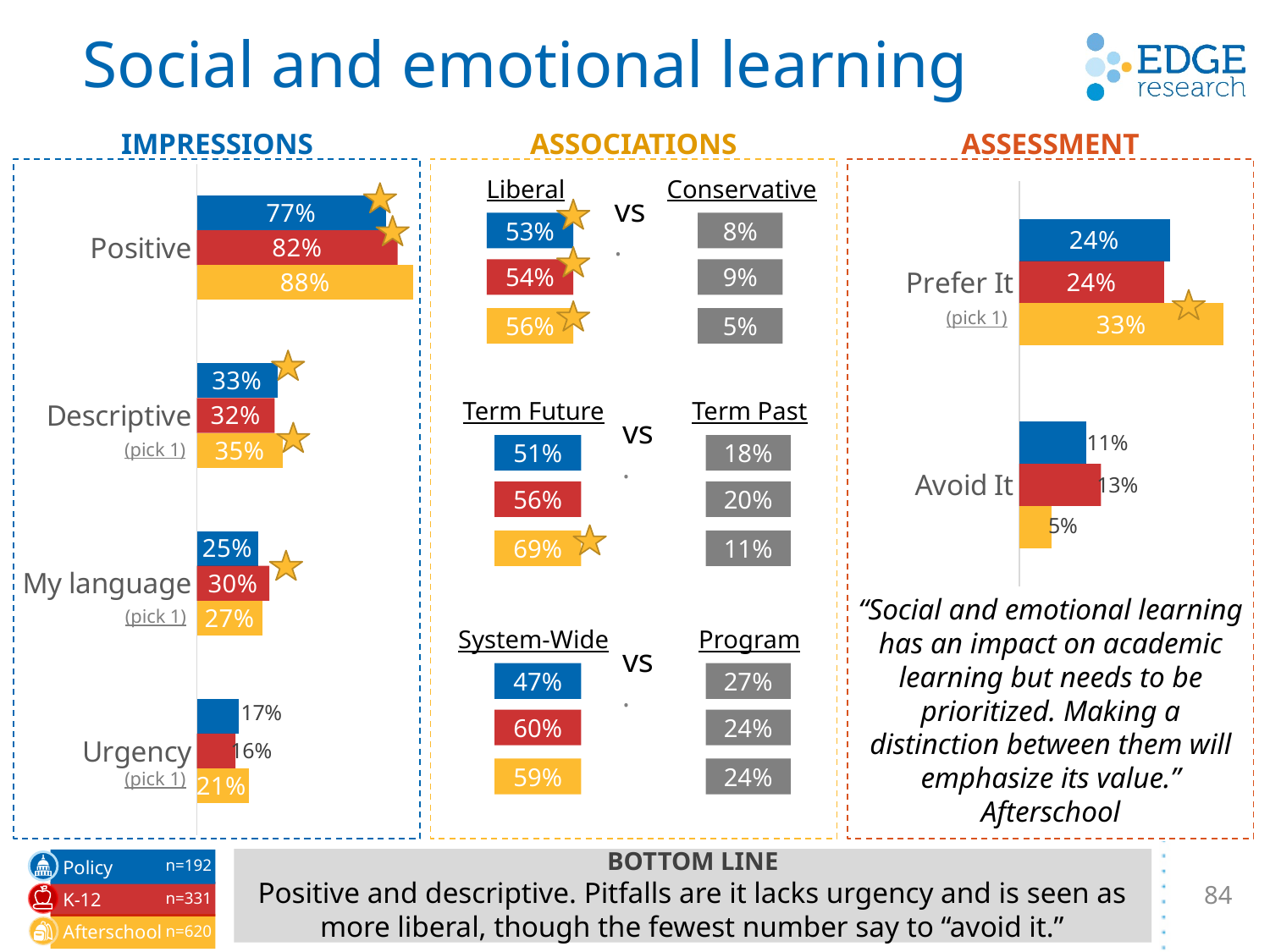
In the ASSOCIATIONS section, what percentage of K-12 respondents associated the term with Liberal? 54% In the IMPRESSIONS chart, how many categories are shown? 4 How many groups does the legend at the bottom left of the slide list? 3 In the IMPRESSIONS chart, which group has the lowest value for Urgency? K-12 In the IMPRESSIONS chart, what is the difference between the Afterschool and Policy values for Positive? 11% In the ASSOCIATIONS section, which group has the highest value for Term Future? Afterschool What type of chart is the IMPRESSIONS chart? Bar chart In the ASSESSMENT chart, is the K-12 value for Avoid It larger or smaller than the Afterschool value for Avoid It? Larger In the IMPRESSIONS chart, what is the Policy value for Urgency? 17% In the ASSESSMENT chart, what is the Afterschool value for Prefer It? 33% In the IMPRESSIONS chart, which group has the highest value for Positive? Afterschool In the IMPRESSIONS chart, what percentage of Afterschool respondents rated the term Positive? 88%